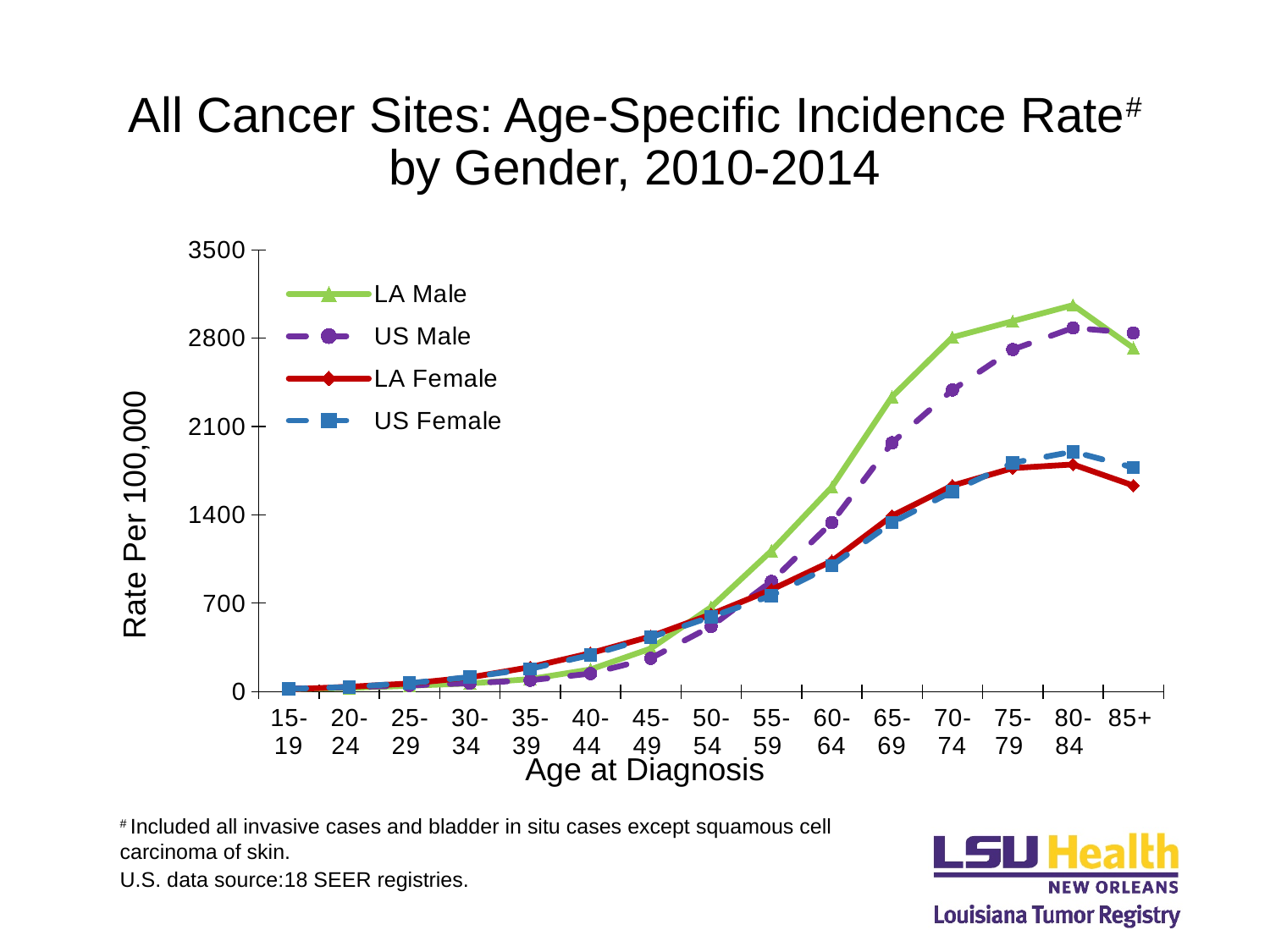
Is the LA Male rate for the 80-84 age group greater or less than 2800? greater Which age group has the highest incidence rate for LA Male? 80-84 Is the LA Female rate for the 85+ age group greater or less than 1400? greater What kind of chart is shown on the slide? Line chart How many age groups are shown on the x axis? 15 What is the label of the y axis? Rate Per 100,000 For the 70-74 age group, which is higher: LA Male or US Male? LA Male How many series does the legend list? 4 Is the LA Male rate for the 65-69 age group greater or less than 2100? greater Which age group has the lowest incidence rate for US Female? 15-19 For the 85+ age group, which is higher: LA Male or US Male? US Male